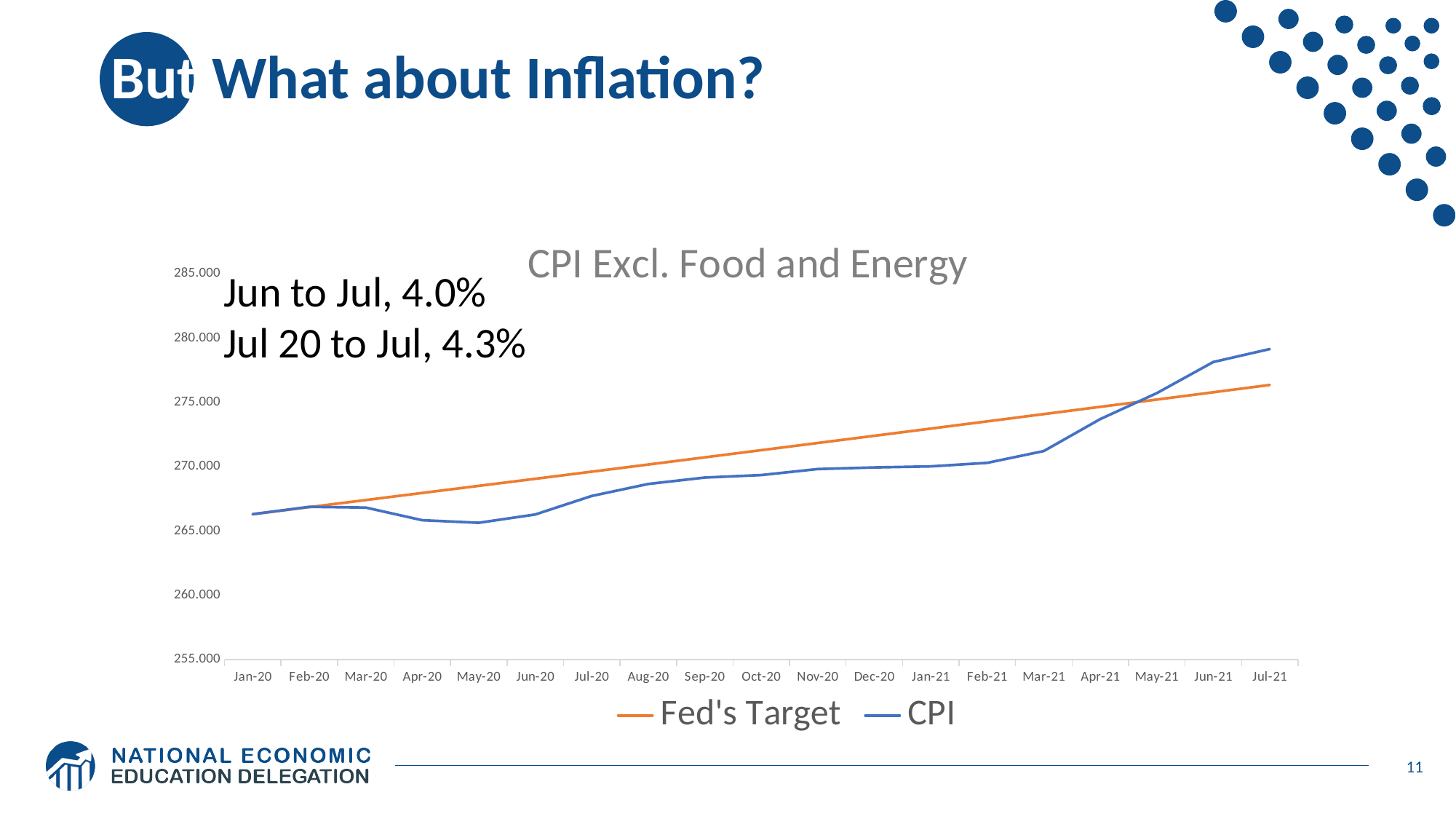
Is the Fed's Target value for Jan-21 greater or less than 270.000? greater What is the title of the chart? CPI Excl. Food and Energy Is the CPI value for May-20 greater or less than 270.000? less In Jul-21, which series is higher, CPI or Fed's Target? CPI Does the CPI line rise or fall overall from Jan-20 to Jul-21? rise How many months are shown along the x axis? 19 What kind of chart is shown on the slide? line chart How many series does the legend list? 2 Is the CPI value for Jul-21 greater or less than 275.000? greater In Dec-20, which series is higher, CPI or Fed's Target? Fed's Target Does the Fed's Target line rise or fall from Jan-20 to Jul-21? rise What percentage is annotated for the change from Jun to Jul? 4.0%